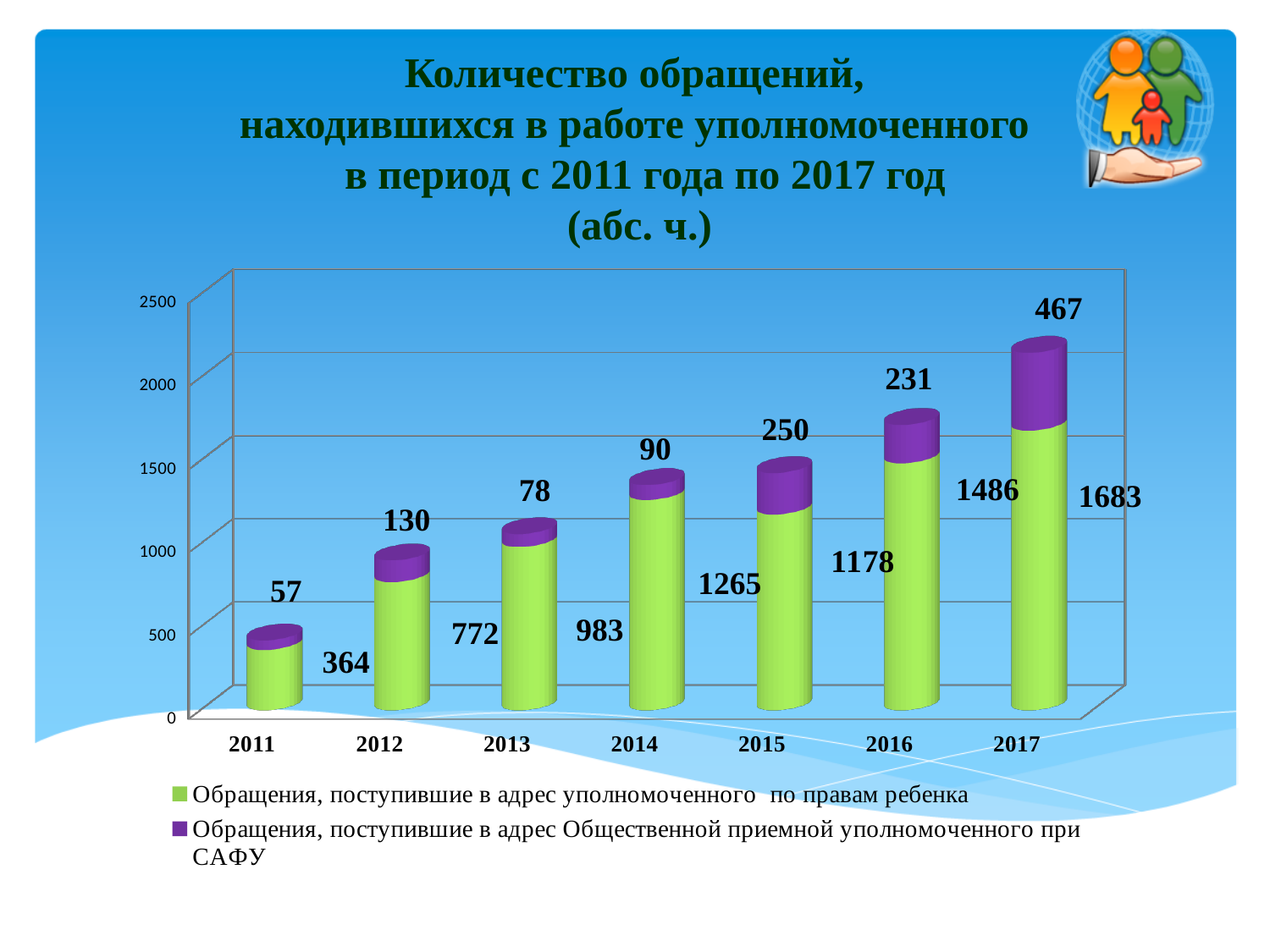
In which year is the value for 'Обращения, поступившие в адрес уполномоченного по правам ребенка' the highest? 2017 What is the difference between the 2016 and 2015 values for 'Обращения, поступившие в адрес уполномоченного по правам ребенка'? 308 What is the value for 2011 for the series 'Обращения, поступившие в адрес уполномоченного по правам ребенка'? 364 In which year is the value for 'Обращения, поступившие в адрес Общественной приемной уполномоченного при САФУ' the lowest? 2011 What kind of chart is shown on the slide? bar chart How many years are shown on the x axis of the chart? 7 What is the value for 2017 for the series 'Обращения, поступившие в адрес Общественной приемной уполномоченного при САФУ'? 467 Which is larger for 'Обращения, поступившие в адрес уполномоченного по правам ребенка': the value for 2014 or the value for 2015? 2014 What is the total of the stacked bar for 2017? 2150 What is the value for 2014 for the series 'Обращения, поступившие в адрес уполномоченного по правам ребенка'? 1265 What is the total of the stacked bar for 2012? 902 How many series does the legend list? 2